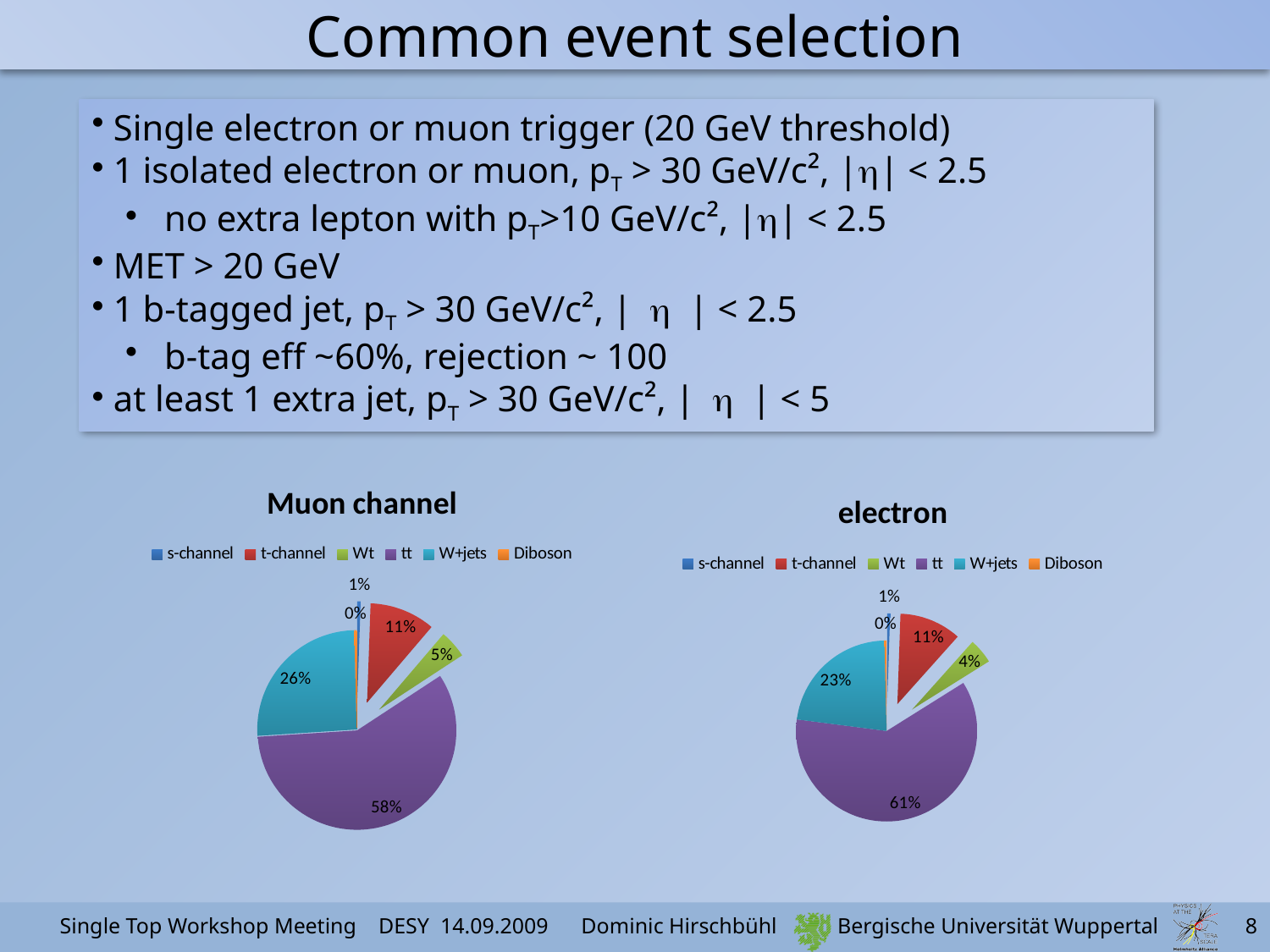
What kind of chart is the electron chart? pie chart In the electron pie chart, what share does Wt have? 4% In the Muon channel pie chart, what share does Wt have? 5% How many series does the legend of the Muon channel chart list? 6 In the Muon channel pie chart, what share does t-channel have? 11% In the Muon channel pie chart, what share does W+jets have? 26% Is the W+jets share larger in the Muon channel chart or in the electron chart? Muon channel In the electron pie chart, which category has the largest slice? tt In the electron pie chart, what share does tt have? 61% In the Muon channel pie chart, what share does tt have? 58% In the electron pie chart, what share does W+jets have? 23% In the Muon channel pie chart, what is the difference between the tt share and the W+jets share? 32%